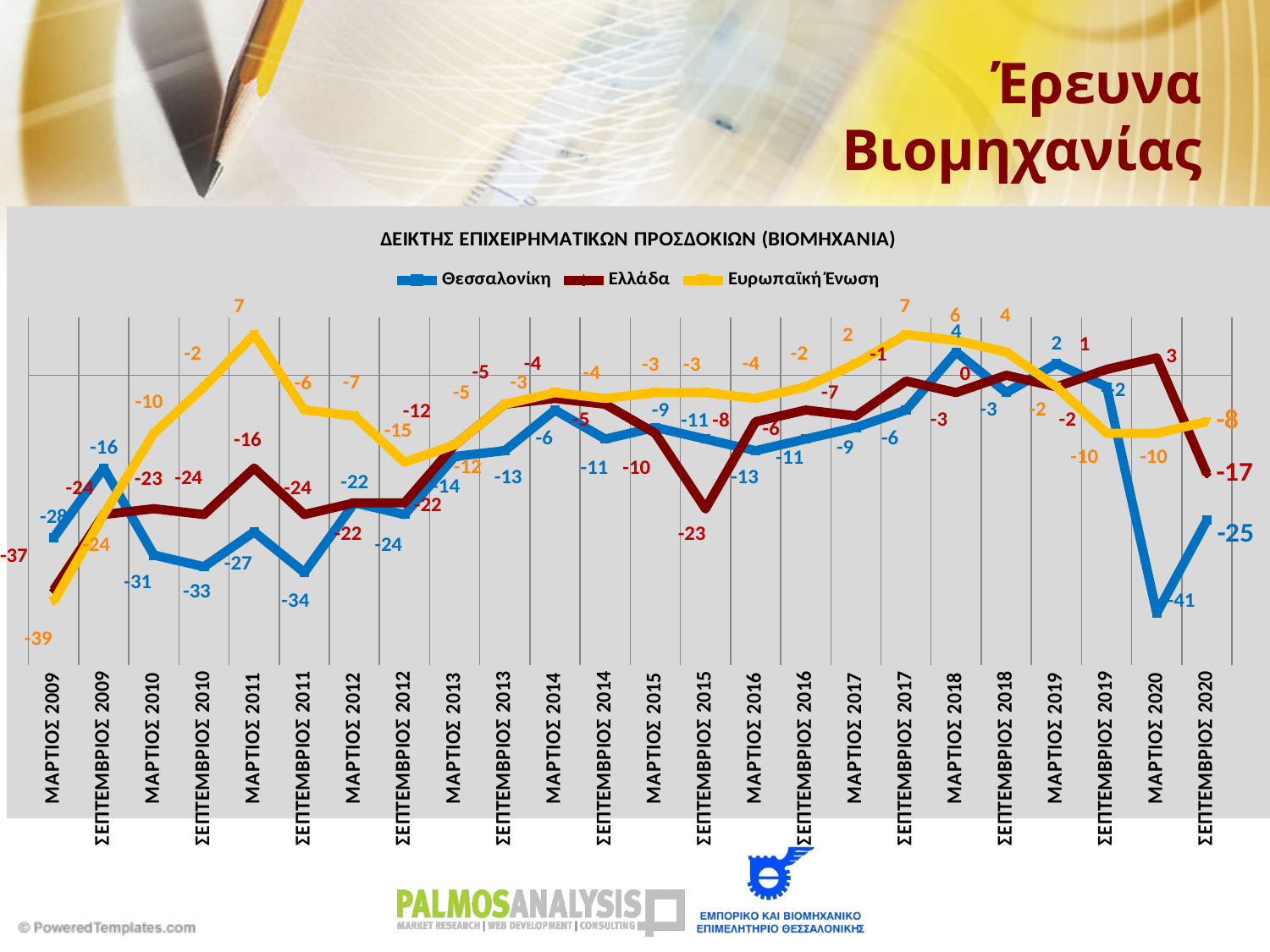
What kind of chart is shown on the slide? Line chart Which colour represents Ελλάδα in the legend? Dark red What is the value for Θεσσαλονίκη in ΜΑΡΤΙΟΣ 2020? -41 How many time points are shown on the x axis? 24 What is the value for Ευρωπαϊκή Ένωση in ΜΑΡΤΙΟΣ 2011? 7 In which period does Θεσσαλονίκη reach its lowest value? ΜΑΡΤΙΟΣ 2020 In which period does Ευρωπαϊκή Ένωση have its lowest value? ΜΑΡΤΙΟΣ 2009 How many series does the legend list? 3 In ΜΑΡΤΙΟΣ 2020, which is larger: the value for Θεσσαλονίκη or for Ευρωπαϊκή Ένωση? Ευρωπαϊκή Ένωση What is the difference between the Ελλάδα and Θεσσαλονίκη values in ΣΕΠΤΕΜΒΡΙΟΣ 2020? 8 What is the value for Ελλάδα in ΣΕΠΤΕΜΒΡΙΟΣ 2020? -17 What is the value for Θεσσαλονίκη in ΣΕΠΤΕΜΒΡΙΟΣ 2011? -34